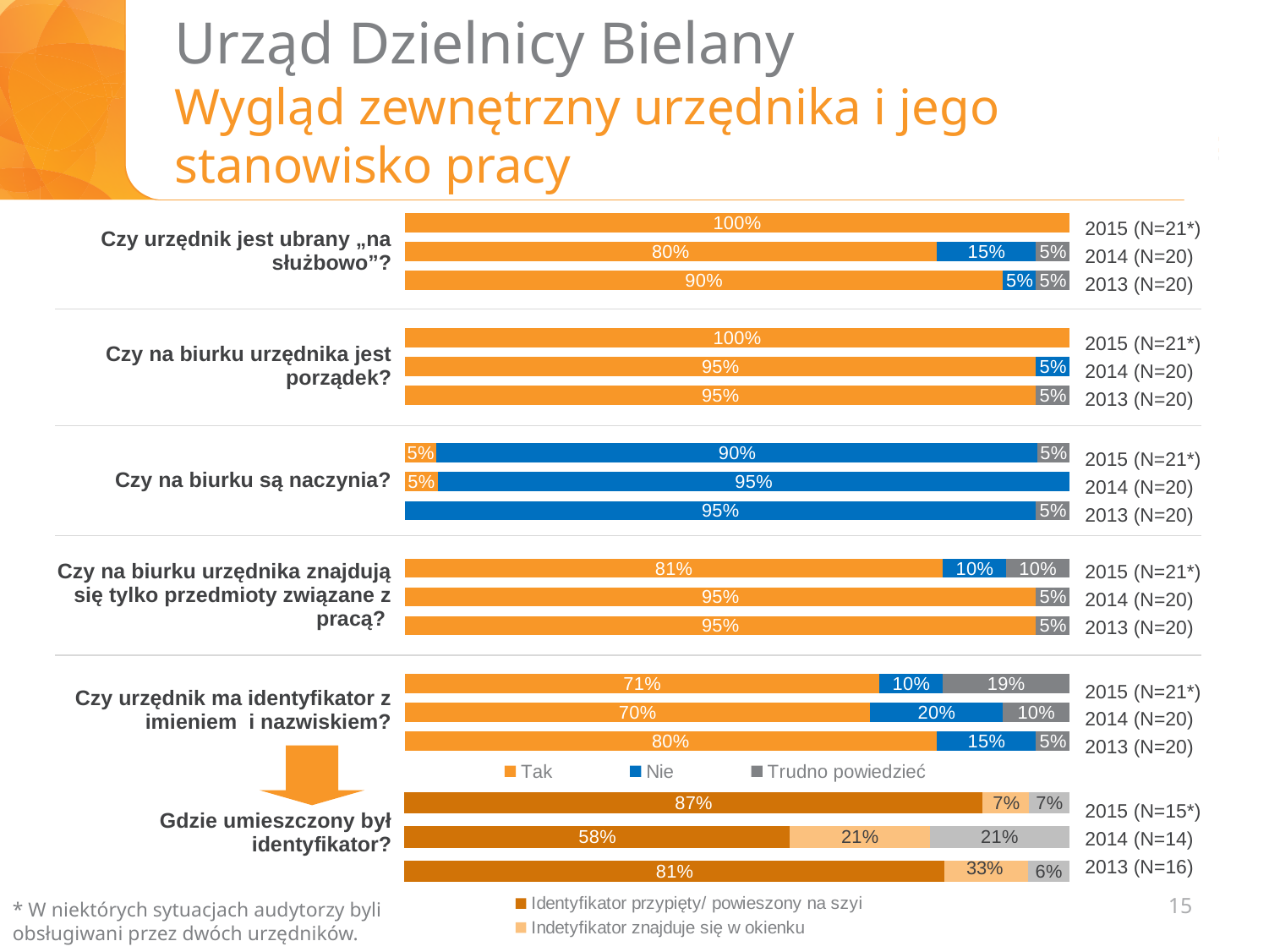
In the chart for "Czy urzędnik jest ubrany „na służbowo”?", what percentage answered "Nie" in 2014 (N=20)? 15% What kind of chart is used on this slide? Stacked bar chart In the chart for "Czy urzędnik ma identyfikator z imieniem i nazwiskiem?", which year has the highest "Tak" share? 2013 (N=20) In the chart for "Gdzie umieszczony był identyfikator?", which year has the highest share for "Identyfikator przypięty/ powieszony na szyi"? 2015 (N=15*) In the chart for "Czy na biurku są naczynia?", what percentage answered "Nie" in 2015 (N=21*)? 90% In the chart for "Gdzie umieszczony był identyfikator?", what percentage had the identifier "przypięty/ powieszony na szyi" in 2014 (N=14)? 58% In the chart for "Czy urzędnik ma identyfikator z imieniem i nazwiskiem?", what percentage answered "Trudno powiedzieć" in 2015 (N=21*)? 19% In the chart for "Czy urzędnik jest ubrany „na służbowo”?", what percentage answered "Tak" in 2014 (N=20)? 80% In the chart for "Gdzie umieszczony był identyfikator?", what is the difference between the "przypięty/ powieszony na szyi" share in 2015 (N=15*) and in 2014 (N=14)? 29% In the chart for "Czy na biurku urzędnika znajdują się tylko przedmioty związane z pracą?", which is larger: the "Tak" share in 2015 (N=21*) or in 2014 (N=20)? 2014 (N=20) How many series does the legend list for the charts with the "Tak" / "Nie" / "Trudno powiedzieć" answers? 3 In the chart for "Czy urzędnik ma identyfikator z imieniem i nazwiskiem?", what is the difference between the "Tak" share in 2013 (N=20) and in 2014 (N=20)? 10%